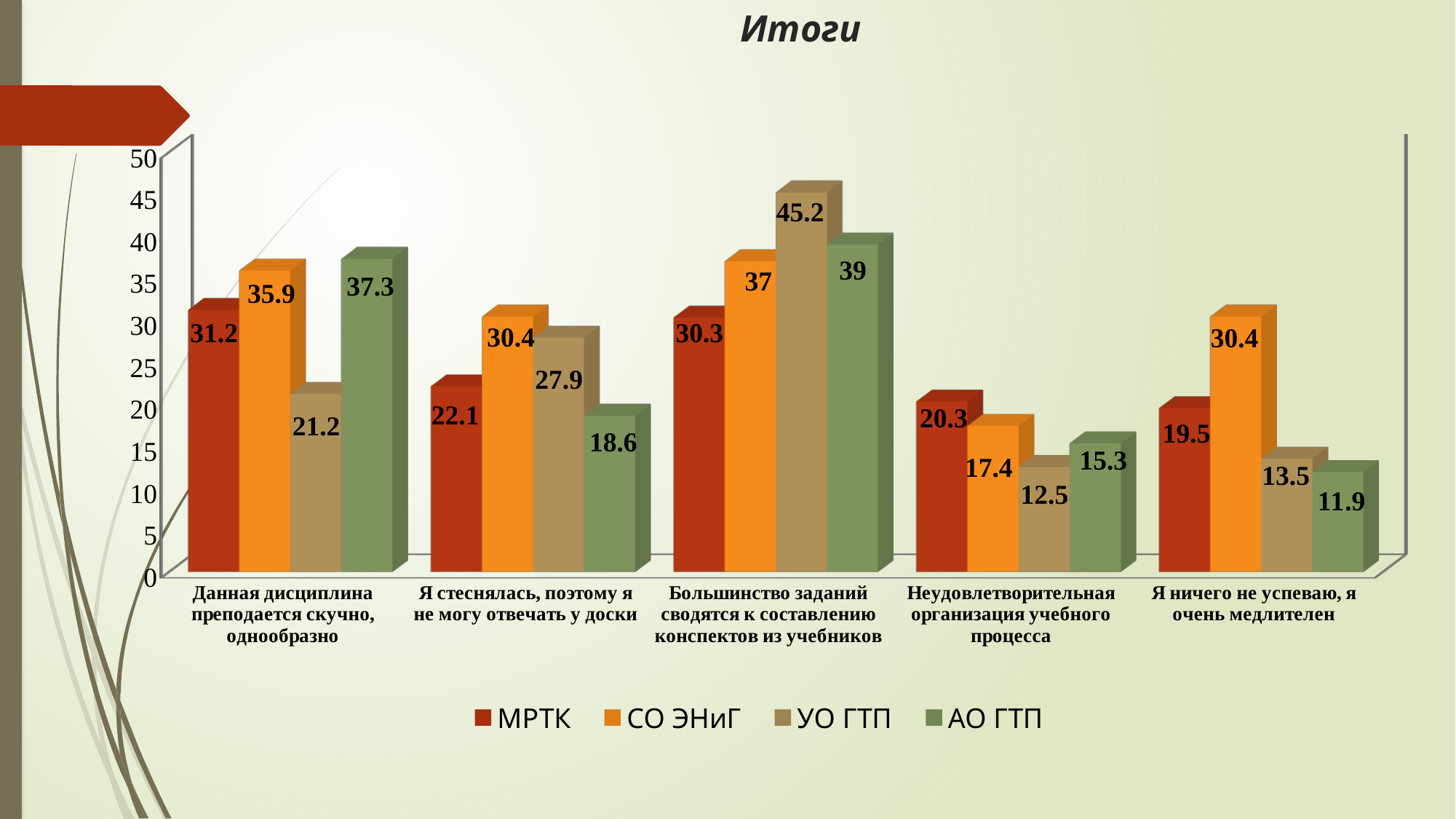
Which is larger in the category "Данная дисциплина преподается скучно, однообразно": the value for МРТК or the value for СО ЭНиГ? СО ЭНиГ What kind of chart is shown on the slide? Bar chart What is the title of the slide? Итоги How many categories are shown on the x axis of the chart? 5 Which series has the highest value in the category "Неудовлетворительная организация учебного процесса"? МРТК What is the value for СО ЭНиГ in the category "Я ничего не успеваю, я очень медлителен"? 30.4 What is the value for АО ГТП in the category "Данная дисциплина преподается скучно, однообразно"? 37.3 What is the difference between the УО ГТП and МРТК values in the category "Большинство заданий сводятся к составлению конспектов из учебников"? 14.9 How many series does the legend list? 4 Which series is shown in orange in the legend? СО ЭНиГ What is the value for УО ГТП in the category "Большинство заданий сводятся к составлению конспектов из учебников"? 45.2 Which series has the lowest value in the category "Я стеснялась, поэтому я не могу отвечать у доски"? АО ГТП